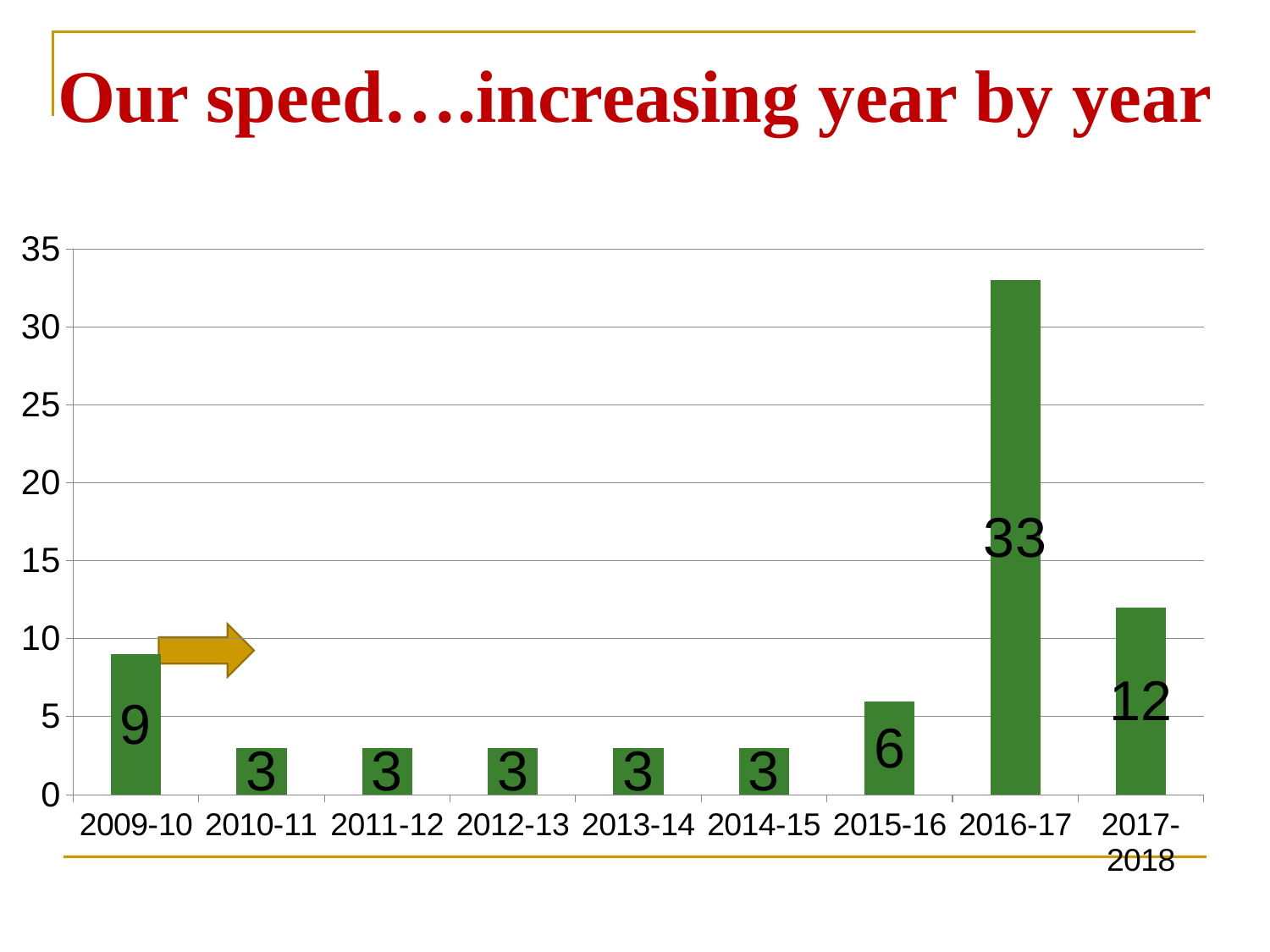
Which is larger, the value for 2009-10 or the value for 2015-16? 2009-10 What is the value for 2017-2018? 12 How many years are shown on the x axis? 9 What is the value for 2009-10? 9 What is the difference between the values for 2009-10 and 2010-11? 6 What is the value for 2015-16? 6 What kind of chart is shown on the slide? bar chart What is the value for 2016-17? 33 What is the title of the slide? Our speed….increasing year by year What is the difference between the values for 2016-17 and 2017-2018? 21 Is the value for 2016-17 greater or less than 30? greater Which year has the highest value? 2016-17